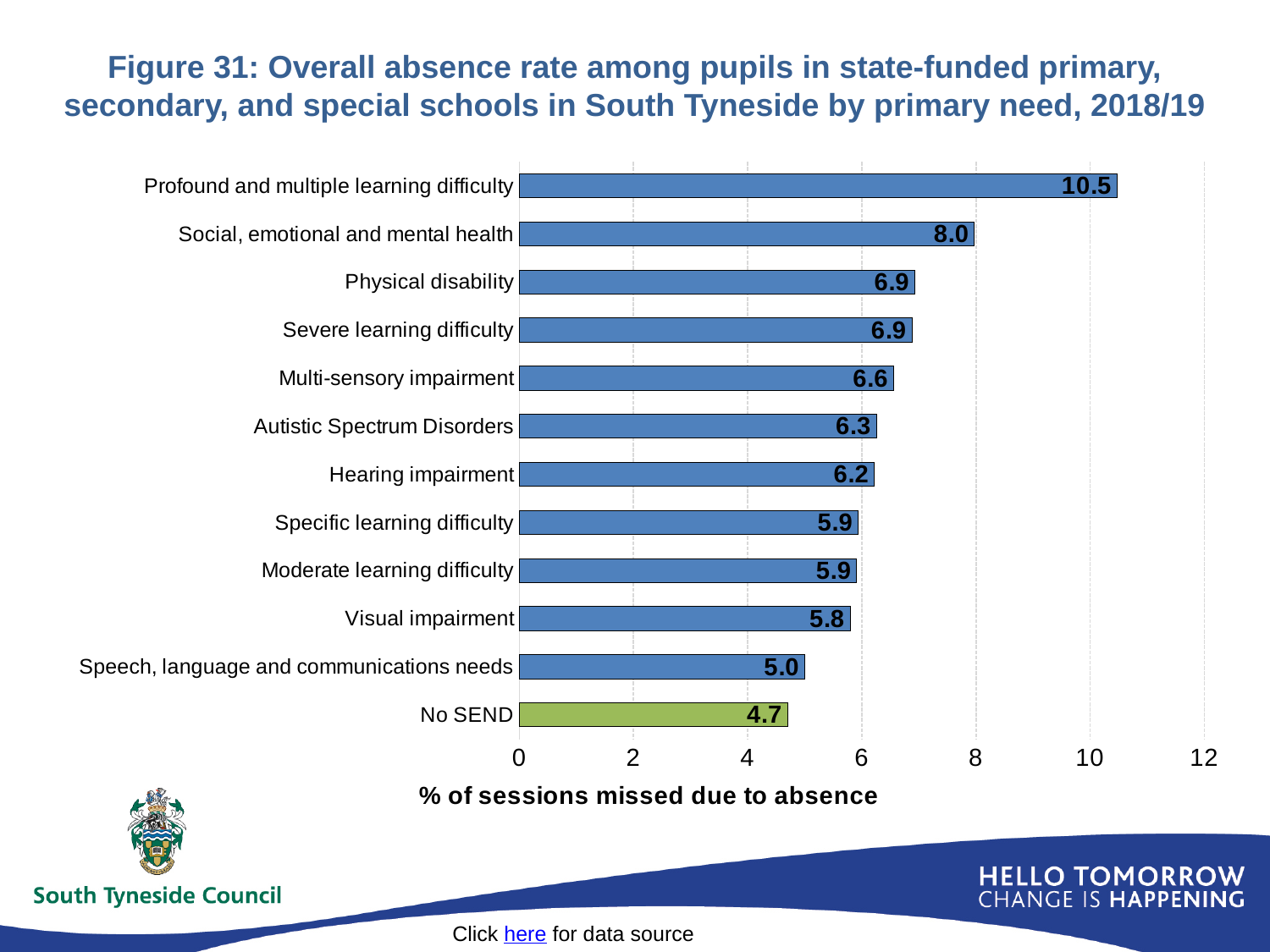
What type of chart is shown on the slide? Bar chart What is the overall absence rate for pupils with No SEND? 4.7 Which primary need has the highest overall absence rate? Profound and multiple learning difficulty Which bar is coloured green rather than blue? No SEND Is the absence rate for Multi-sensory impairment greater or less than 6? greater How many primary need categories are shown in the chart? 12 Which category has the lowest overall absence rate? No SEND What is the overall absence rate for pupils with Speech, language and communications needs? 5.0 What is the label of the x axis? % of sessions missed due to absence What is the overall absence rate for pupils with Profound and multiple learning difficulty? 10.5 Which has a higher absence rate: Autistic Spectrum Disorders or Visual impairment? Autistic Spectrum Disorders What is the difference in absence rate between Social, emotional and mental health and No SEND? 3.3